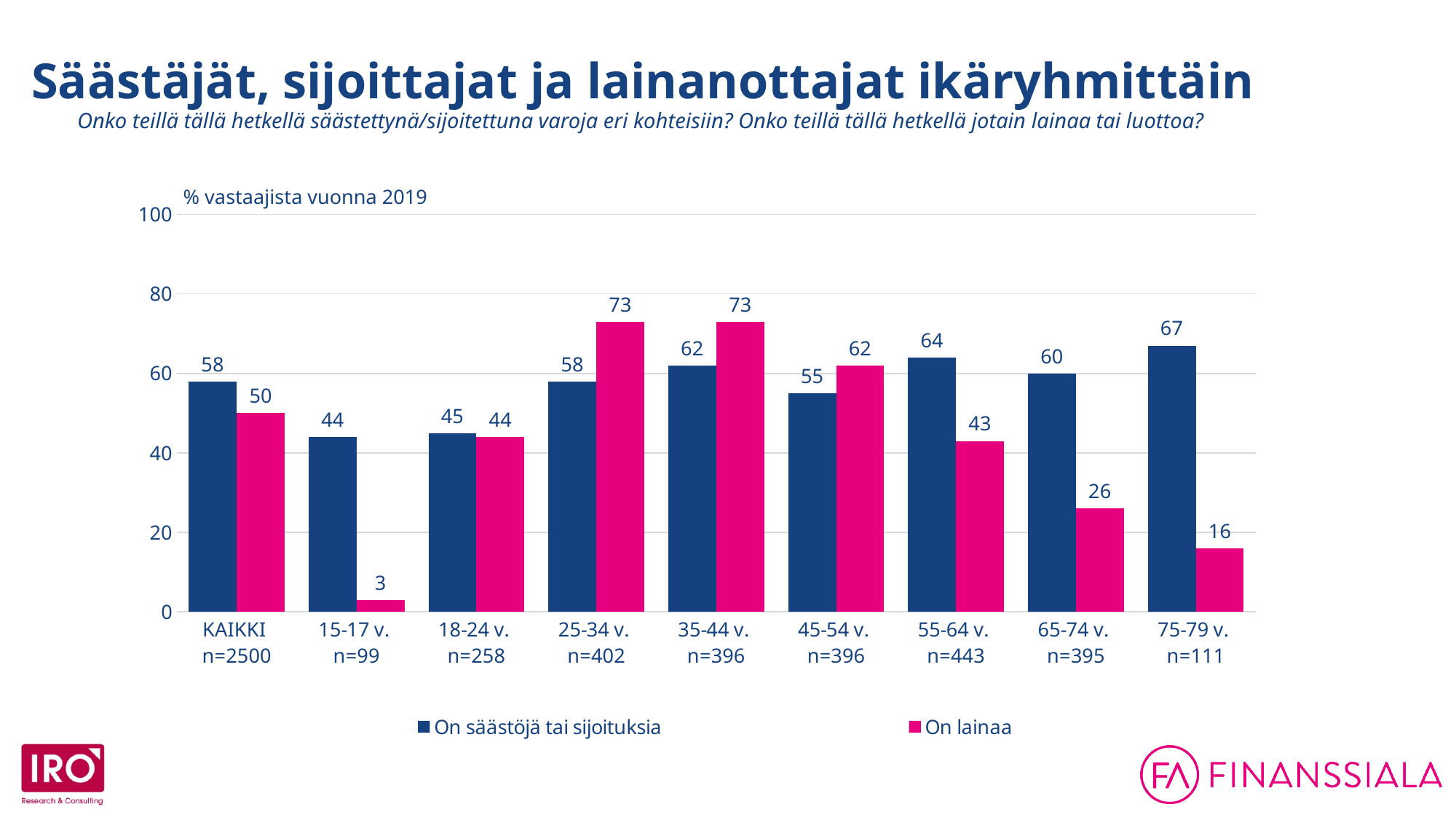
Is the value for 'On lainaa' in the 35-44 v. age group greater or less than 60? greater What is the value for 'On lainaa' for KAIKKI? 50 What is the value for 'On säästöjä tai sijoituksia' in the 75-79 v. age group? 67 What is the value for 'On lainaa' in the 15-17 v. age group? 3 Which age group has the lowest value for 'On lainaa'? 15-17 v. What is the sample size (n) shown for the 55-64 v. age group? n=443 In the 55-64 v. age group, which is larger: 'On säästöjä tai sijoituksia' or 'On lainaa'? On säästöjä tai sijoituksia How many categories are shown on the x axis? 9 What is the difference between 'On lainaa' and 'On säästöjä tai sijoituksia' in the 25-34 v. age group? 15 How many series does the legend list? 2 What kind of chart is shown on the slide? Bar chart Which age group has the highest value for 'On säästöjä tai sijoituksia'? 75-79 v.